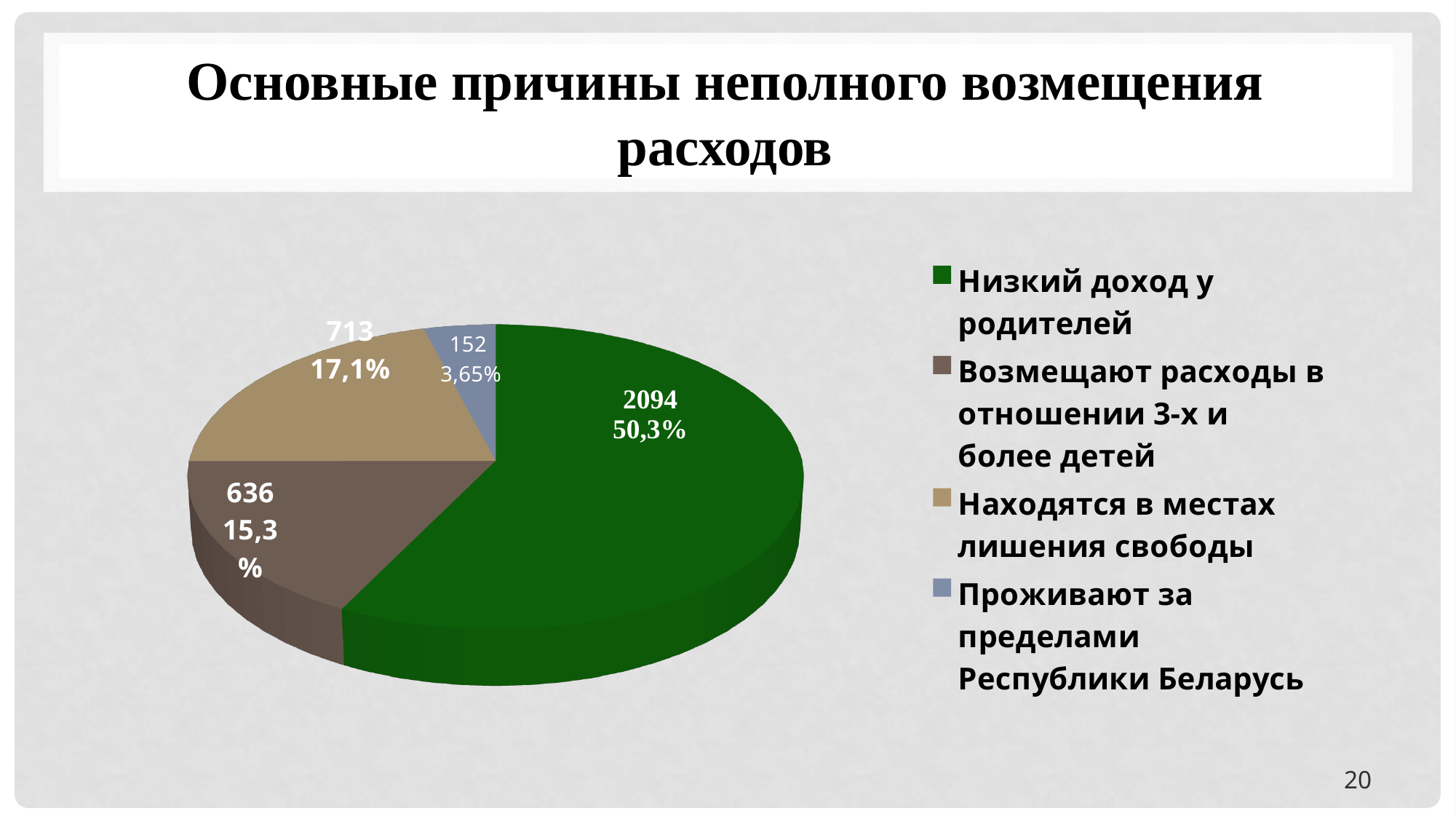
What percentage is shown for the slice 'Возмещают расходы в отношении 3-х и более детей'? 15,3% What kind of chart is shown on the slide? Pie chart What value is shown for the slice 'Низкий доход у родителей'? 2094 What value is shown for the slice 'Находятся в местах лишения свободы'? 713 Which category has the largest slice in the pie chart? Низкий доход у родителей How many slices does the pie chart have? 4 What is the difference between the values for 'Находятся в местах лишения свободы' and 'Возмещают расходы в отношении 3-х и более детей'? 77 What value is shown for the slice 'Проживают за пределами Республики Беларусь'? 152 What colour is the slice for 'Низкий доход у родителей'? Green What percentage is shown for the slice 'Низкий доход у родителей'? 50,3% Which category has the smallest slice in the pie chart? Проживают за пределами Республики Беларусь Which is larger: the value for 'Находятся в местах лишения свободы' or the value for 'Возмещают расходы в отношении 3-х и более детей'? Находятся в местах лишения свободы